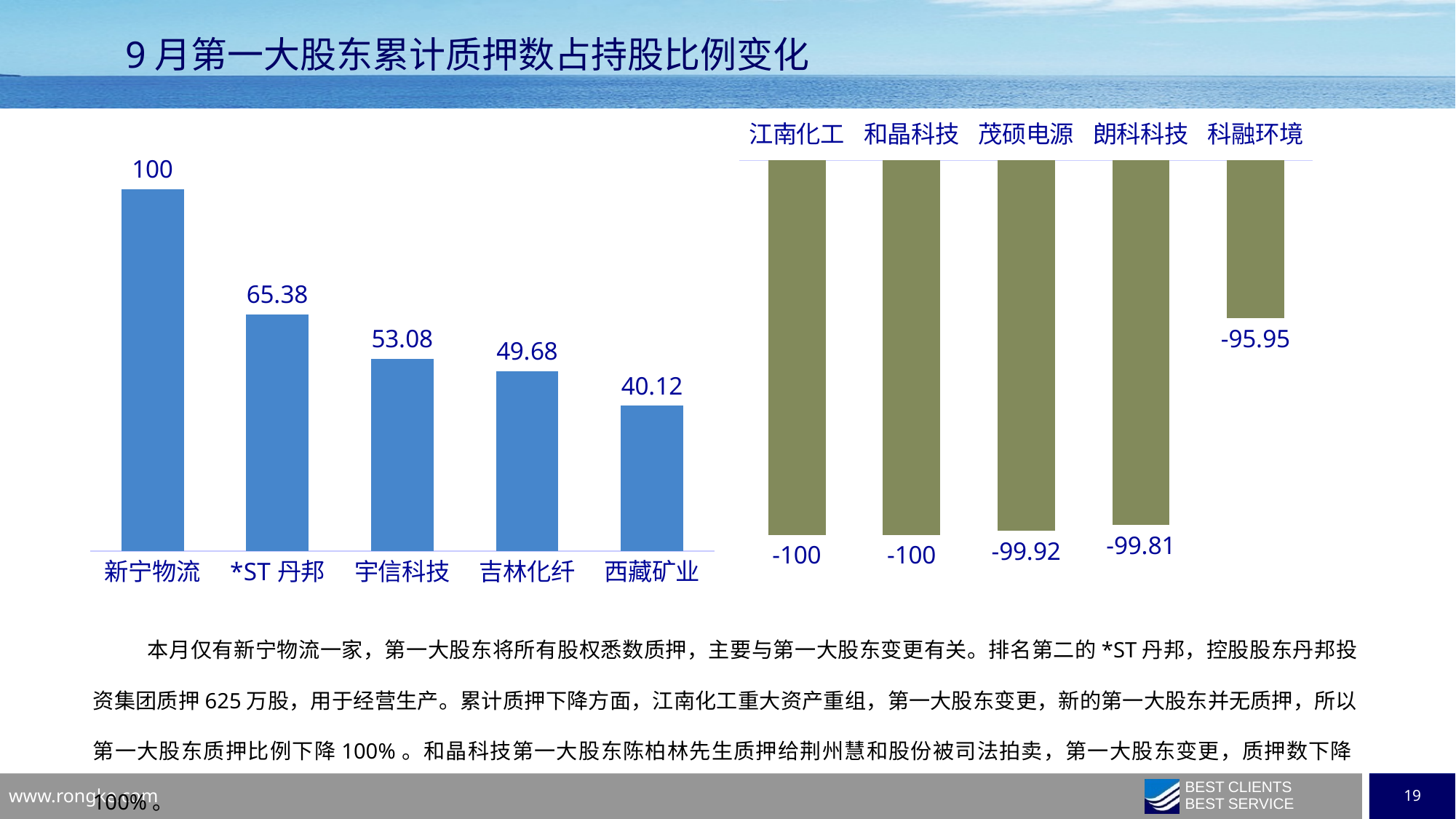
How many categories are shown in the right chart? 5 In the left chart, what is the value for 新宁物流? 100 In the right chart, what is the value for 朗科科技? -99.81 In the left chart, do the values rise or fall from left to right? fall In the right chart, which category has the highest (least negative) value? 科融环境 In the left chart, which is larger, the value for 宇信科技 or the value for 吉林化纤? 宇信科技 What kind of chart is the left chart? bar chart In the right chart, what is the value for 科融环境? -95.95 In the left chart, what is the difference between the values for *ST 丹邦 and 西藏矿业? 25.26 In the left chart, what is the value for 宇信科技? 53.08 In the left chart, which category has the highest value? 新宁物流 In the left chart, which category has the lowest value? 西藏矿业